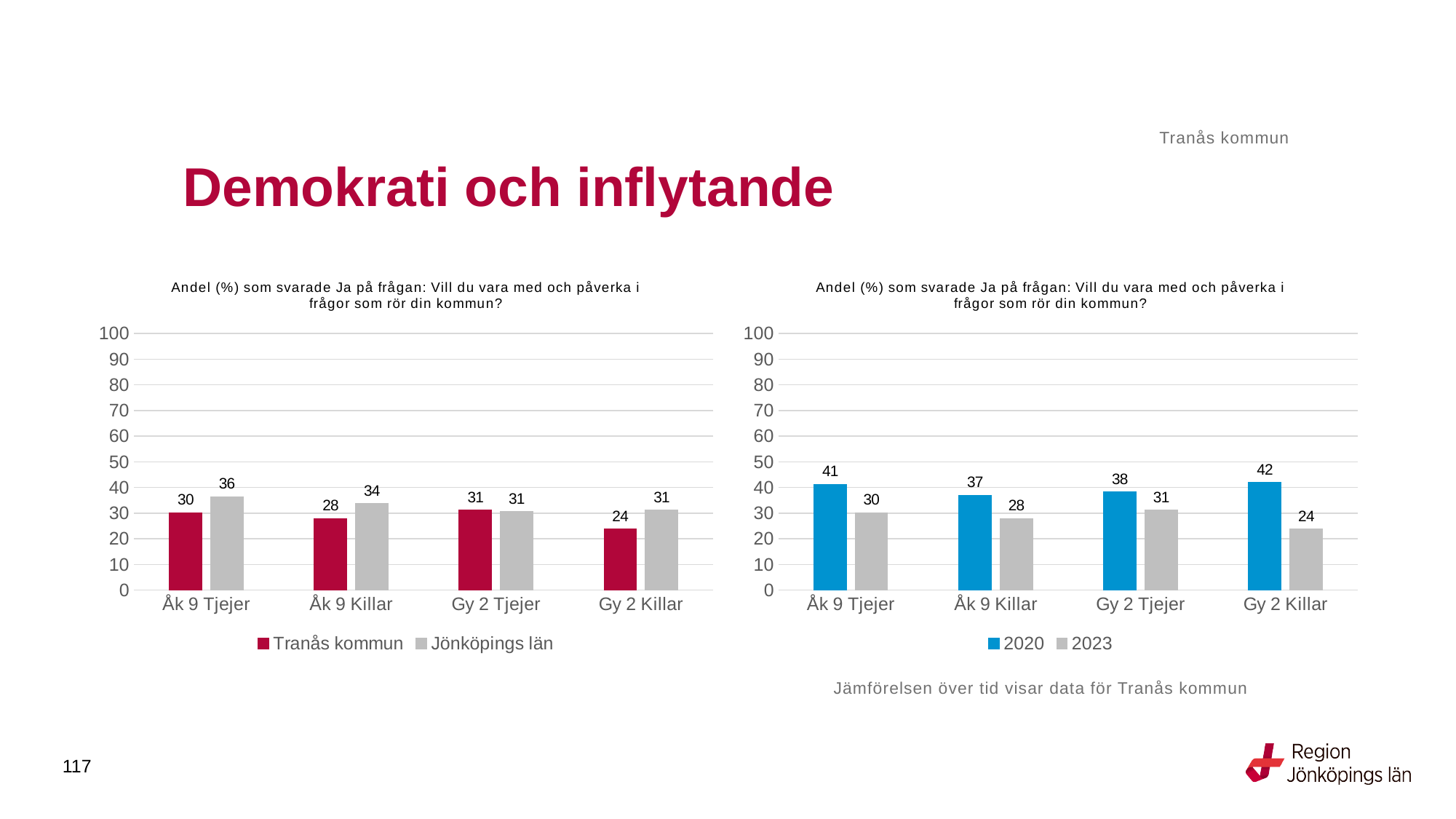
How many series does the legend of the left chart list? 2 In the left chart, what is the value for Jönköpings län for Åk 9 Tjejer? 36 In the right chart, what is the difference between the 2020 and 2023 values for Gy 2 Killar? 18 In the left chart, what is the difference between Jönköpings län and Tranås kommun for Gy 2 Killar? 7 In the right chart, which category has the highest 2020 value? Gy 2 Killar In the left chart, which is larger for Åk 9 Killar: Tranås kommun or Jönköpings län? Jönköpings län In the left chart, what is the value for Tranås kommun for Gy 2 Killar? 24 In the right chart, what is the 2020 value for Gy 2 Killar? 42 How many categories are shown on the x axis of the right chart? 4 In the left chart, which category has the lowest Tranås kommun value? Gy 2 Killar What kind of chart is the right chart? Bar chart In the right chart, what is the 2023 value for Åk 9 Killar? 28